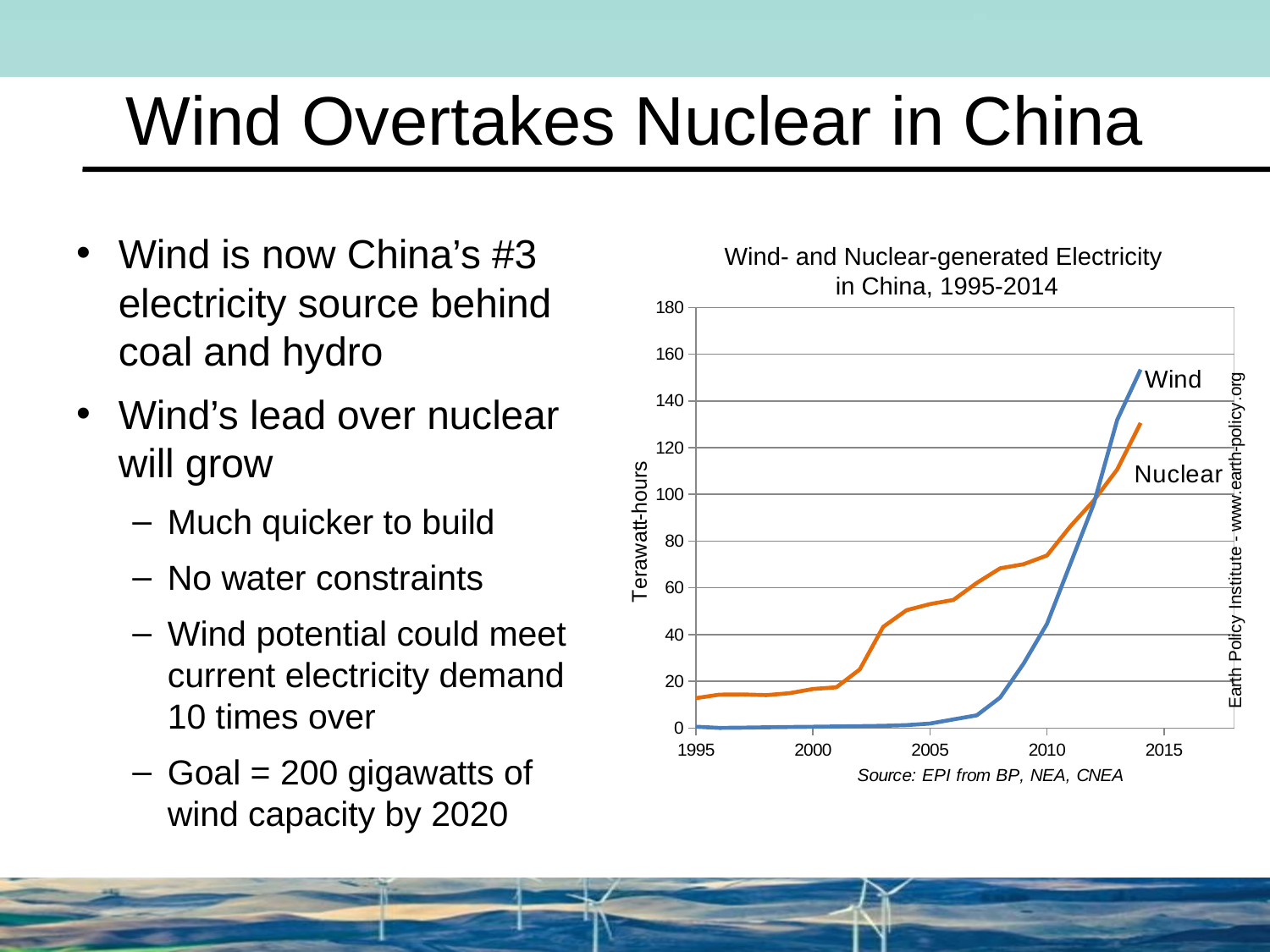
Is the value for Wind in 2014 greater or less than 140? greater Does the Wind line rise or fall from 1995 to 2014? rise Does the Nuclear line rise or fall from 1995 to 2014? rise What unit is shown on the y-axis of the chart? Terawatt-hours What is the title of the chart? Wind- and Nuclear-generated Electricity in China, 1995-2014 Is the value for Nuclear in 2014 greater or less than 140? less In 2014, which series has the higher value, Wind or Nuclear? Wind Is the value for Nuclear in 2010 greater or less than 60? greater In 2005, which series has the higher value, Wind or Nuclear? Nuclear What kind of chart is shown on the slide? line chart How many series are plotted in the chart? 2